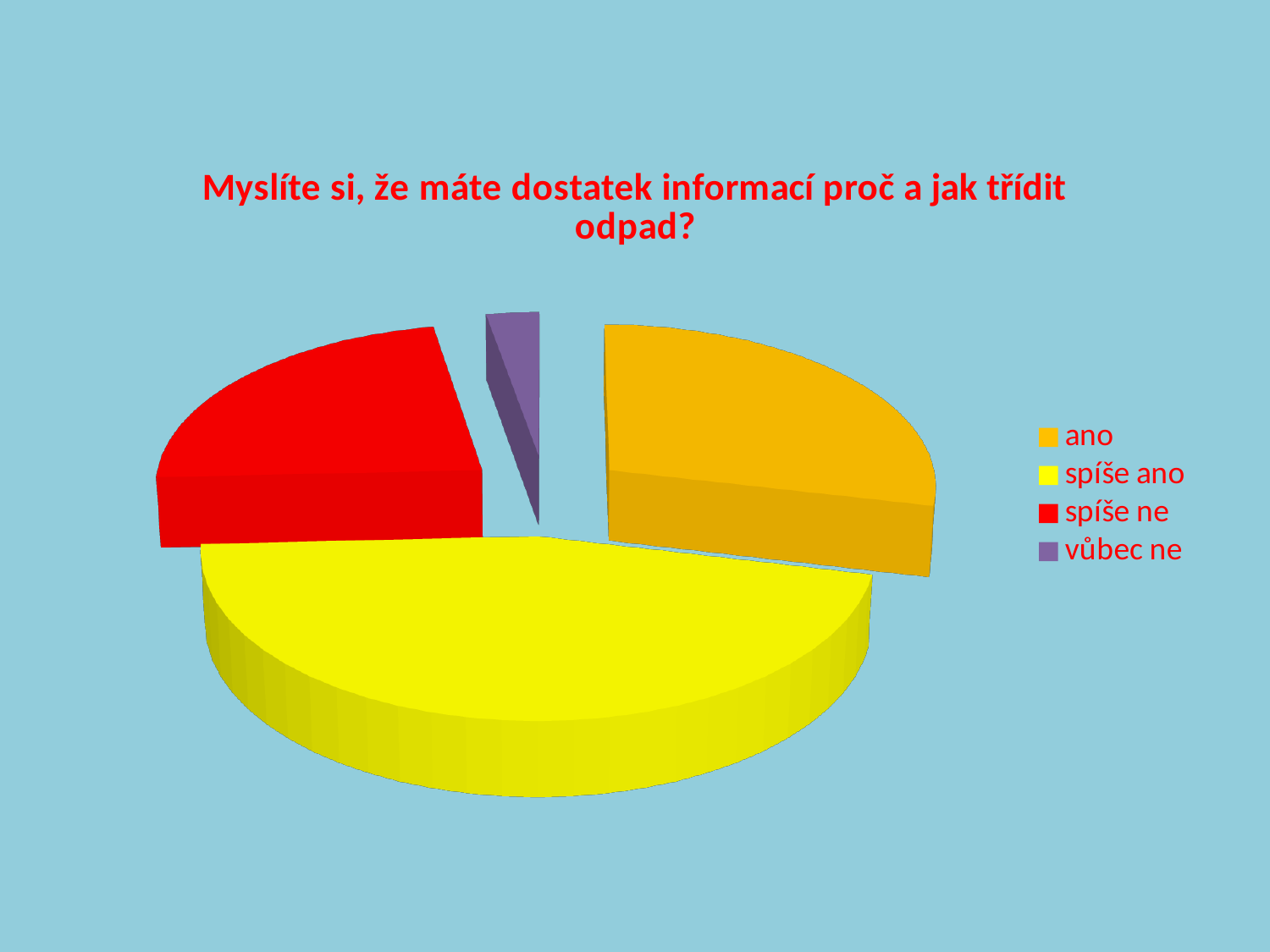
Which category has the smallest slice of the pie? vůbec ne Which slice is larger, "ano" or "vůbec ne"? ano How many slices does the pie chart have? 4 Which slice is larger, "spíše ano" or "ano"? spíše ano How many entries does the legend list? 4 What kind of chart is shown on the slide? pie chart What is the title of the chart? Myslíte si, že máte dostatek informací proč a jak třídit odpad? Which slice is larger, "spíše ne" or "vůbec ne"? spíše ne Which category has the largest slice of the pie? spíše ano What colour is the "spíše ne" slice? red